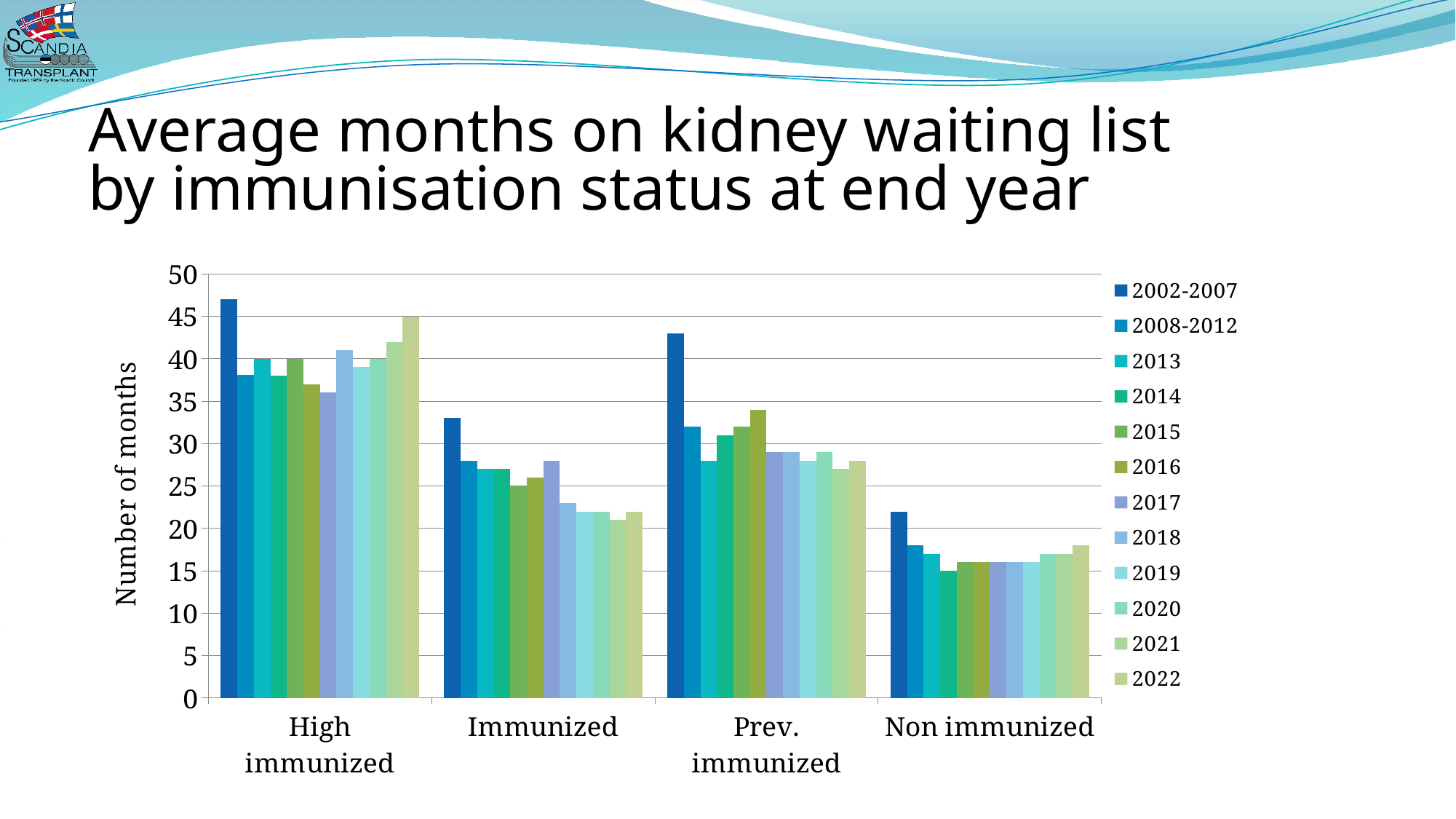
What kind of chart is shown on the slide? bar chart Is the value for 2002-2007 in the Non immunized category greater or less than 25? less What is the title of the y axis? Number of months Is the value for 2022 in the Non immunized category greater or less than 20? less Which category has the highest value for the 2002-2007 series? High immunized For the 2002-2007 series, which is larger: Immunized or Prev. immunized? Prev. immunized Is the value for 2002-2007 in the High immunized category greater or less than 45? greater How many series does the legend list? 12 Which category has the lowest values overall? Non immunized How many immunisation status categories are shown on the x axis? 4